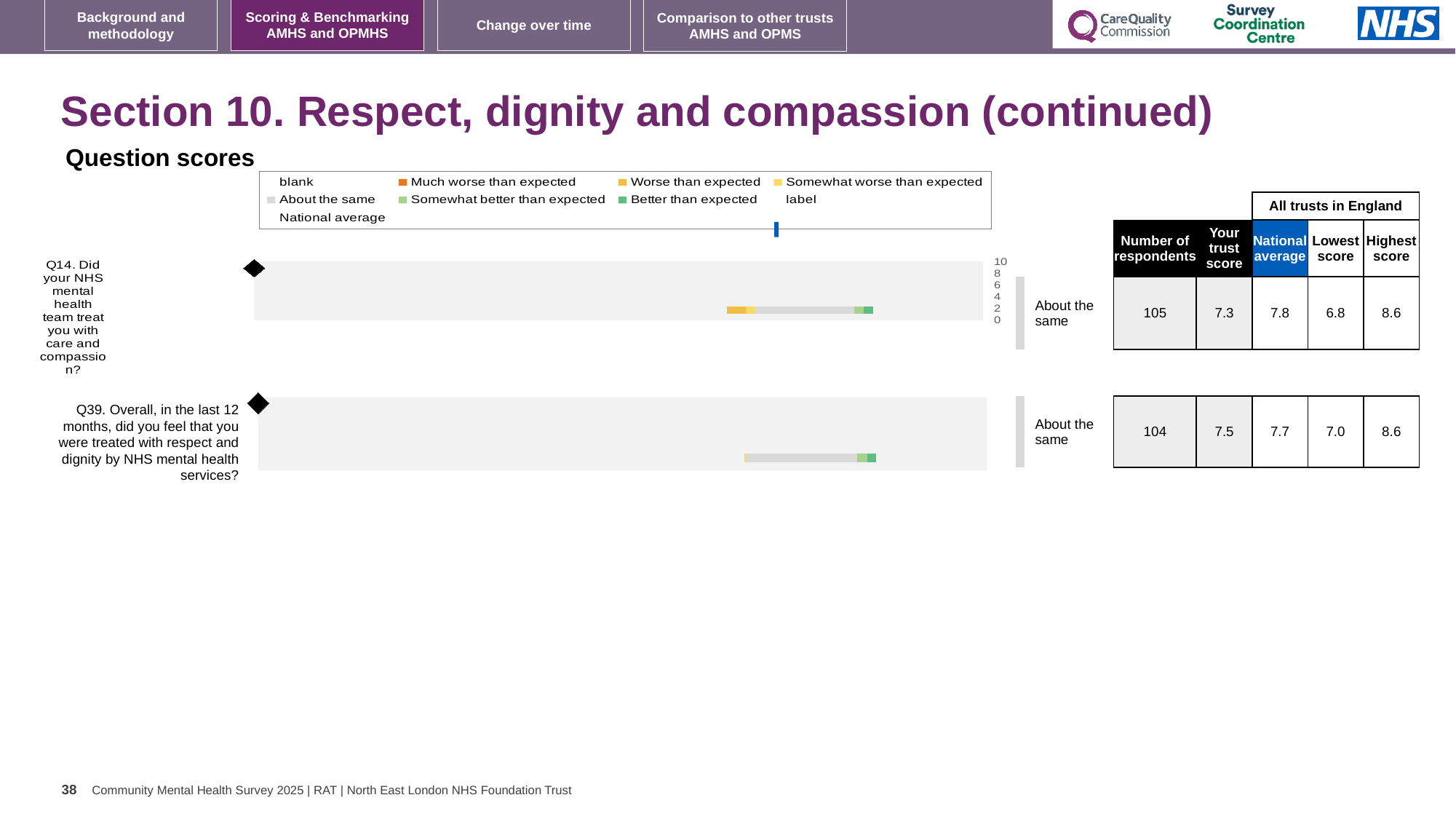
Which question has more respondents, Q14 or Q39? Q14 For Q14, which is larger: the trust score or the national average? National average What is the national average for Q39? 7.7 What is the 'Your trust score' value for Q14? 7.3 What kind of chart is used to show the question scores on this slide? bar chart Which question has the higher trust score, Q14 or Q39? Q39 What benchmark category is shown next to the bar for Q14? About the same Which legend entry is shown with the darker green colour? Better than expected What is the lowest score among all trusts in England for Q39? 7.0 What is the difference between the highest score and the lowest score for Q14? 1.8 How many respondents answered Q14? 105 How many questions are plotted in the question scores chart? 2